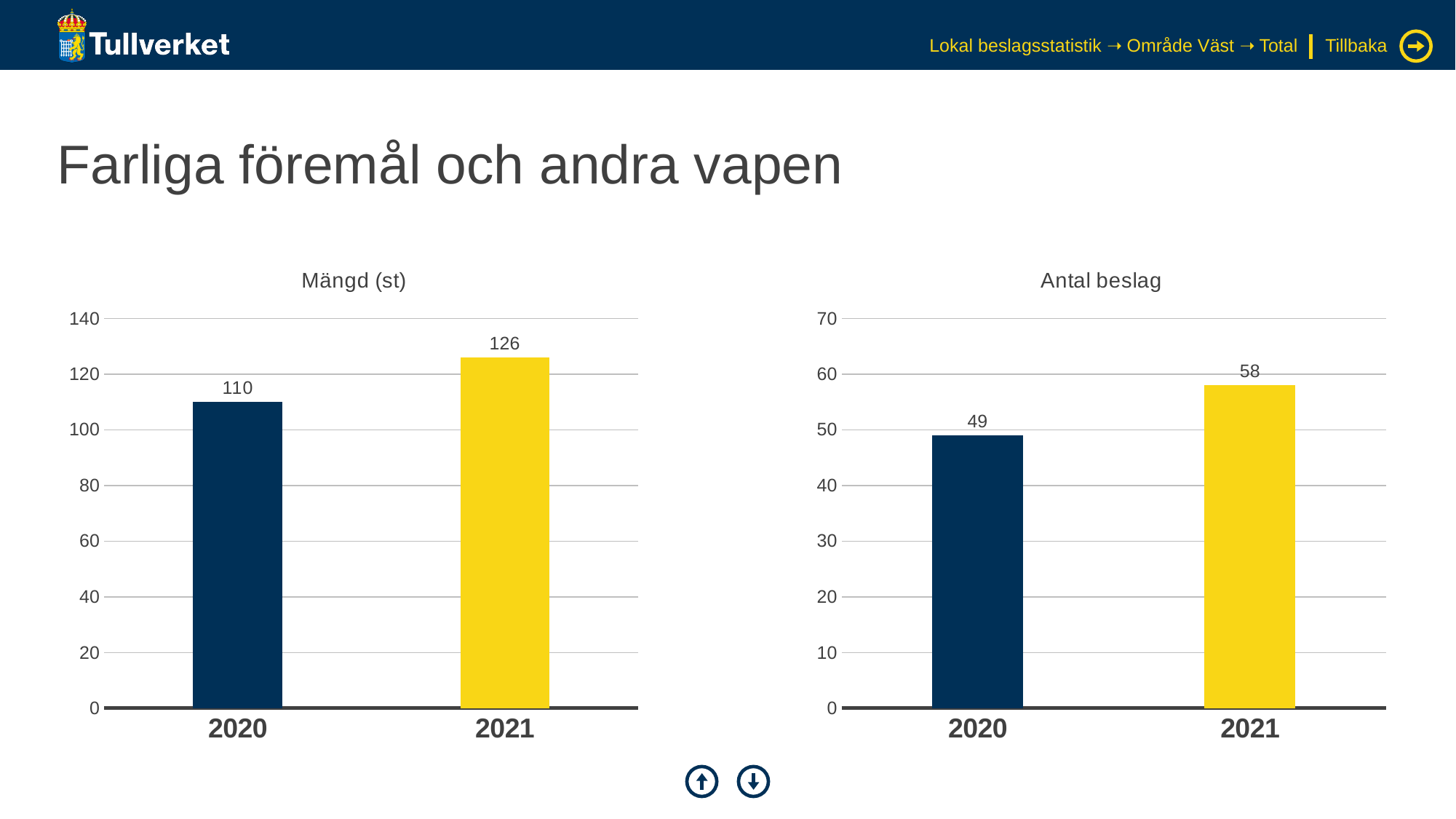
In the 'Antal beslag' chart, what is the difference between the values for 2021 and 2020? 9 In the 'Antal beslag' chart, what is the value for 2020? 49 In the 'Mängd (st)' chart, what is the difference between the values for 2021 and 2020? 16 What kind of chart is the 'Antal beslag' chart? bar chart In the 'Antal beslag' chart, what is the value for 2021? 58 In the 'Mängd (st)' chart, what is the value for 2020? 110 In the 'Mängd (st)' chart, what is the value for 2021? 126 In the 'Mängd (st)' chart, do the values rise or fall from 2020 to 2021? rise How many categories are shown on the x axis of the 'Mängd (st)' chart? 2 In the 'Antal beslag' chart, which year has the lowest value? 2020 In the 'Antal beslag' chart, is the value for 2020 greater or less than 50? less In the 'Mängd (st)' chart, which year has the highest value? 2021